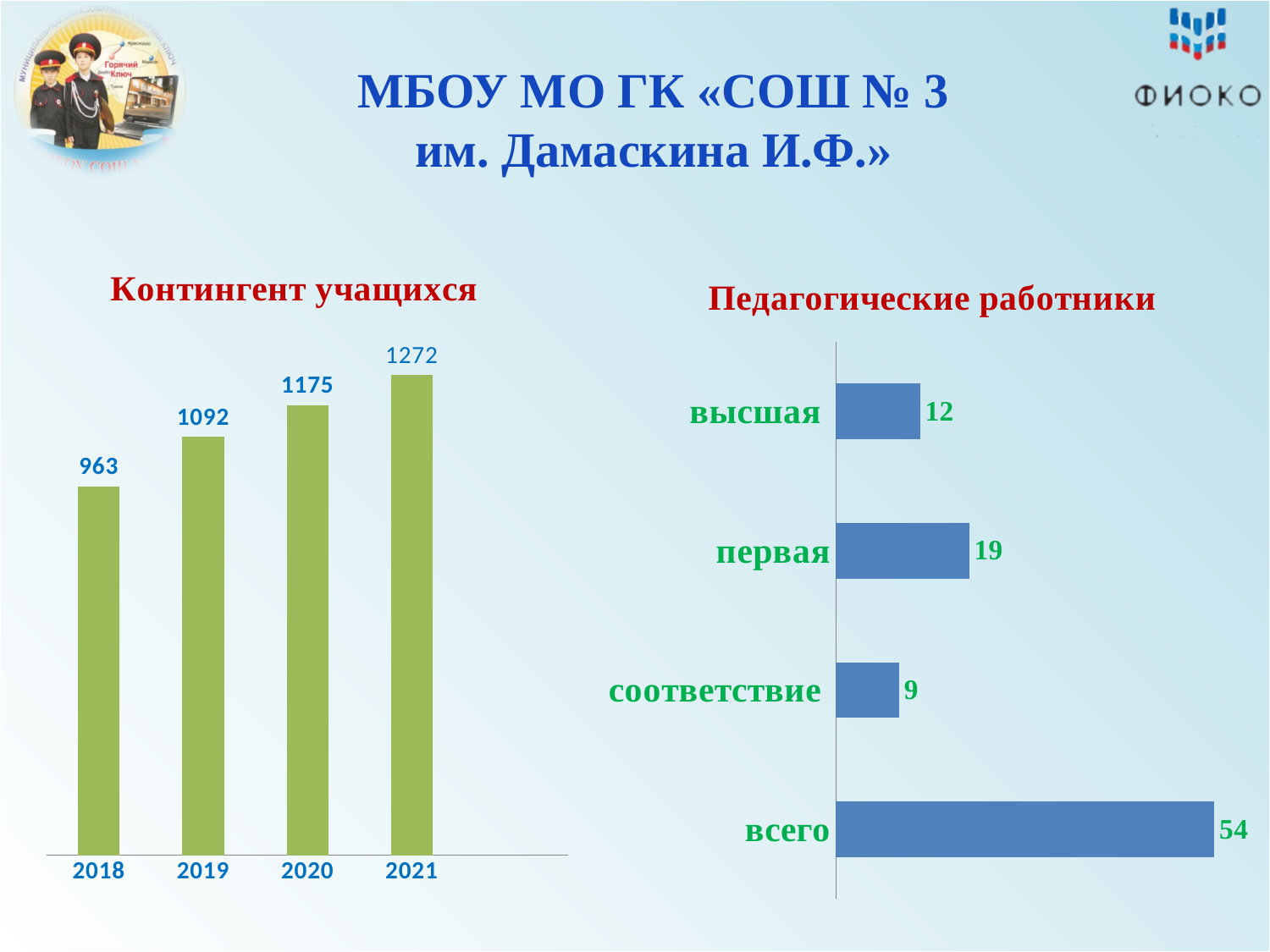
In the "Педагогические работники" chart, what is the value for "соответствие"? 9 In the "Контингент учащихся" chart, what is the value for 2018? 963 In the "Педагогические работники" chart, which category has the smallest value? соответствие In the "Контингент учащихся" chart, which year has the highest value? 2021 In the "Контингент учащихся" chart, what is the difference between the values for 2020 and 2019? 83 In the "Контингент учащихся" chart, do the values rise or fall from 2018 to 2021? rise In the "Педагогические работники" chart, what is the value for "первая"? 19 In the "Педагогические работники" chart, which is larger: "высшая" or "первая"? первая What kind of chart is the "Педагогические работники" chart? bar chart In the "Контингент учащихся" chart, what is the value for 2021? 1272 In the "Контингент учащихся" chart, which year has the lowest value? 2018 In the "Контингент учащихся" chart, how many years are shown? 4